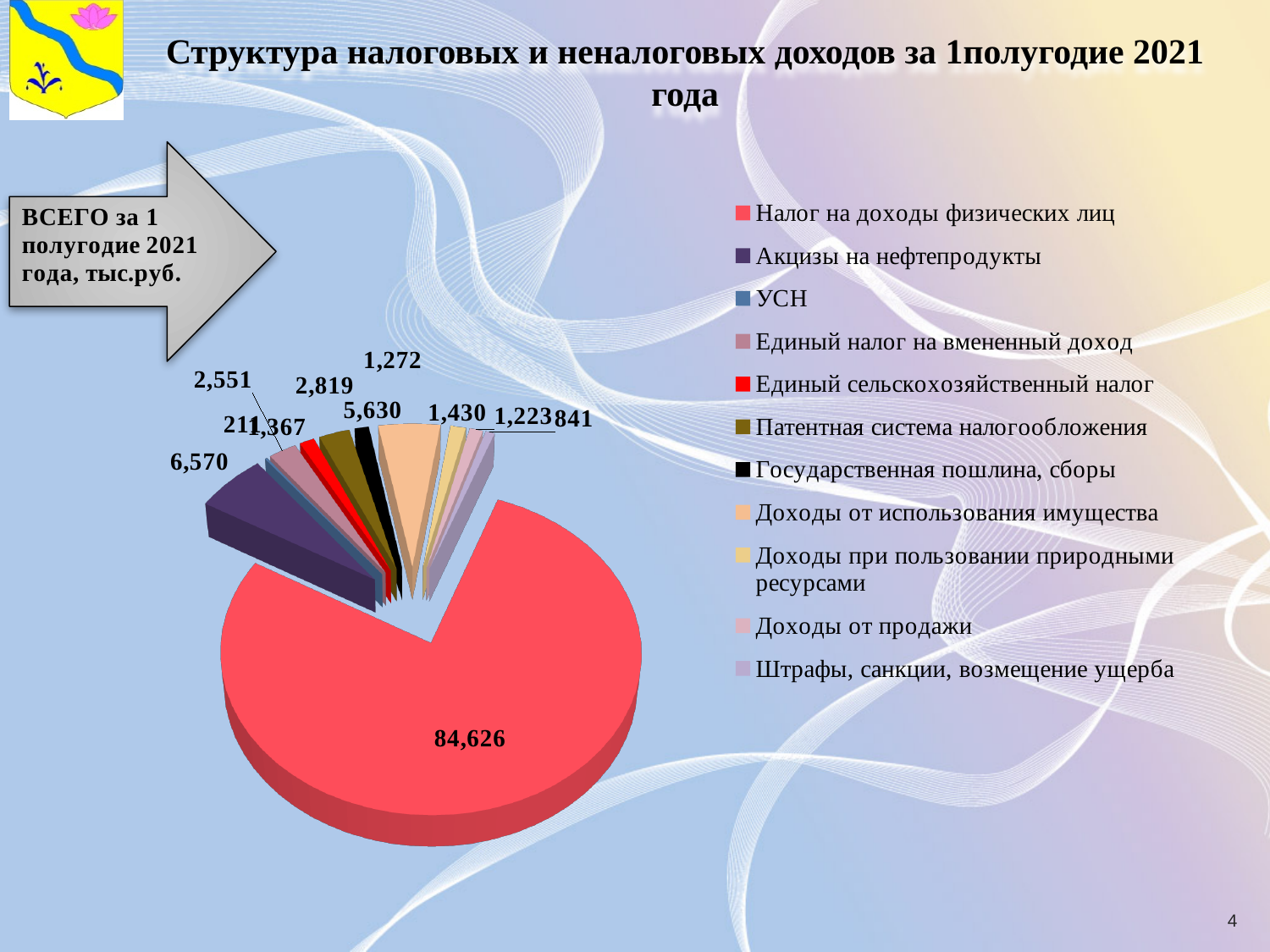
What is the value shown for УСН? 211 What is the smallest value labelled on the pie chart? 211 What is the value shown for Доходы от использования имущества? 5,630 What is the difference between the value for Налог на доходы физических лиц and the value for Акцизы на нефтепродукты? 78,056 How many categories does the legend of the pie chart list? 11 What is the value shown for Акцизы на нефтепродукты? 6,570 Which is larger: the slice for Налог на доходы физических лиц or the slice for Акцизы на нефтепродукты? Налог на доходы физических лиц What is the title of the slide's chart? Структура налоговых и неналоговых доходов за 1полугодие 2021 года Which category has the largest slice in the pie chart? Налог на доходы физических лиц What colour is the slice for Налог на доходы физических лиц? red What kind of chart is shown on the slide? pie chart What is the value of the largest slice of the pie chart? 84,626